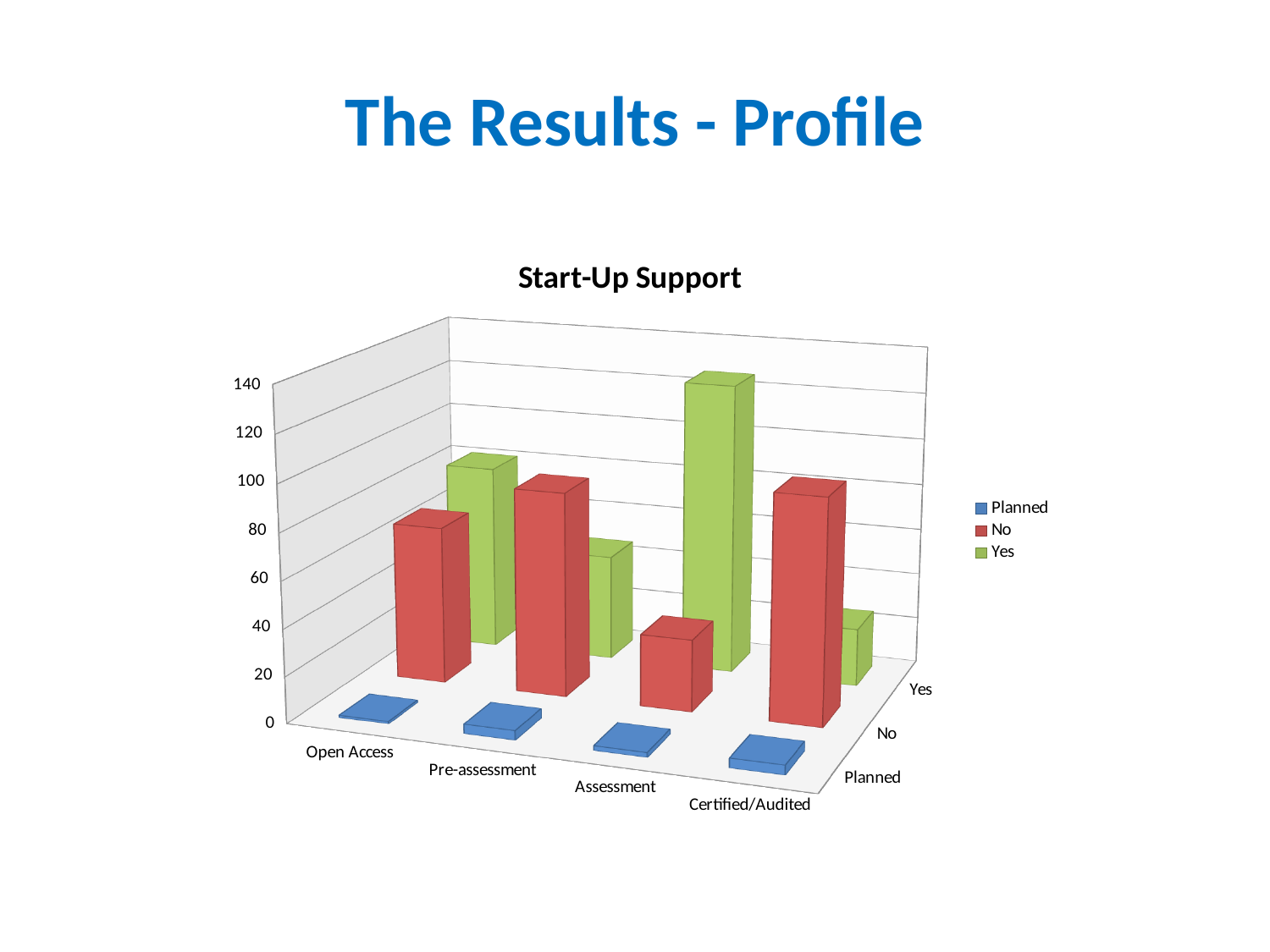
Is the Planned value for Open Access greater or less than 20? less Which category has the lowest value in the Yes series? Certified/Audited What is the title of the chart on the slide? Start-Up Support Is the Yes value for Assessment greater or less than 100? greater Which category has the lowest value in the No series? Assessment Is the Yes value for Certified/Audited greater or less than 60? less How many series does the legend list? 3 What kind of chart is shown on the slide? bar chart Which is larger, the No value for Open Access or the No value for Assessment? Open Access Which colour represents the Yes series in the legend? green Which category has the highest value in the Yes series? Assessment How many categories are shown along the x axis? 4